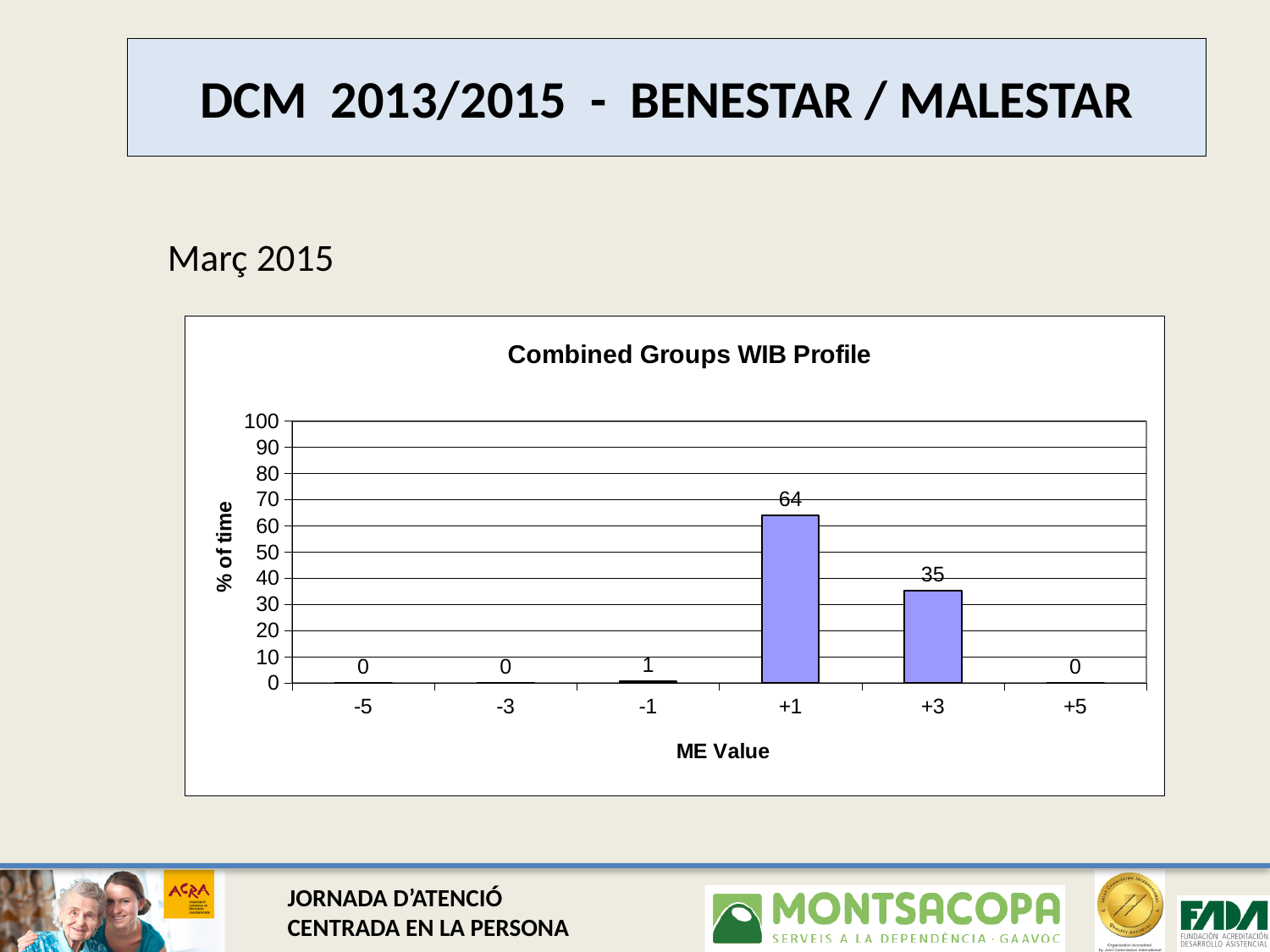
Which ME Value category has the highest % of time? +1 What kind of chart is shown? bar chart Which is larger, the value for +3 or the value for -1? +3 What is the title of the chart? Combined Groups WIB Profile What is the label of the y axis? % of time Is the value for +1 greater or less than 50? greater How many ME Value categories are shown on the x axis? 6 What is the difference between the values for +1 and +3? 29 What is the value for ME Value -1? 1 What is the value for ME Value -5? 0 What is the value for ME Value +3? 35 What is the value for ME Value +1? 64